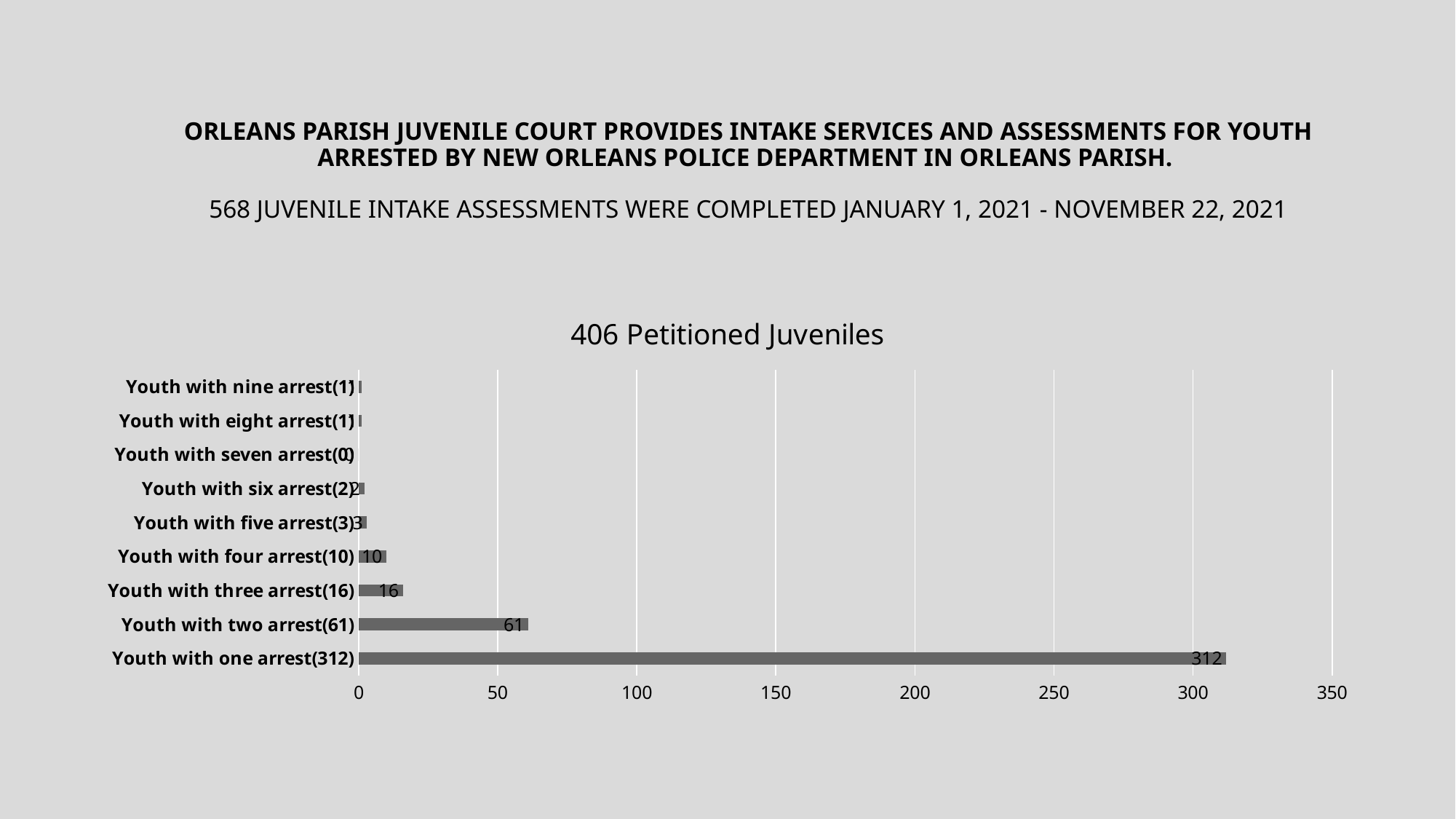
What kind of chart is shown on the slide? bar chart What is the value for Youth with two arrest? 61 Is the value for Youth with one arrest greater or less than 300? greater Which category has the highest value? Youth with one arrest How many categories does the chart show? 9 Which category has the lowest value? Youth with seven arrest What is the value for Youth with three arrest? 16 What is the value for Youth with one arrest? 312 What is the title of the chart? 406 Petitioned Juveniles Which is larger, the value for Youth with two arrest or Youth with three arrest? Youth with two arrest What is the value for Youth with four arrest? 10 What is the difference between the values for Youth with one arrest and Youth with two arrest? 251